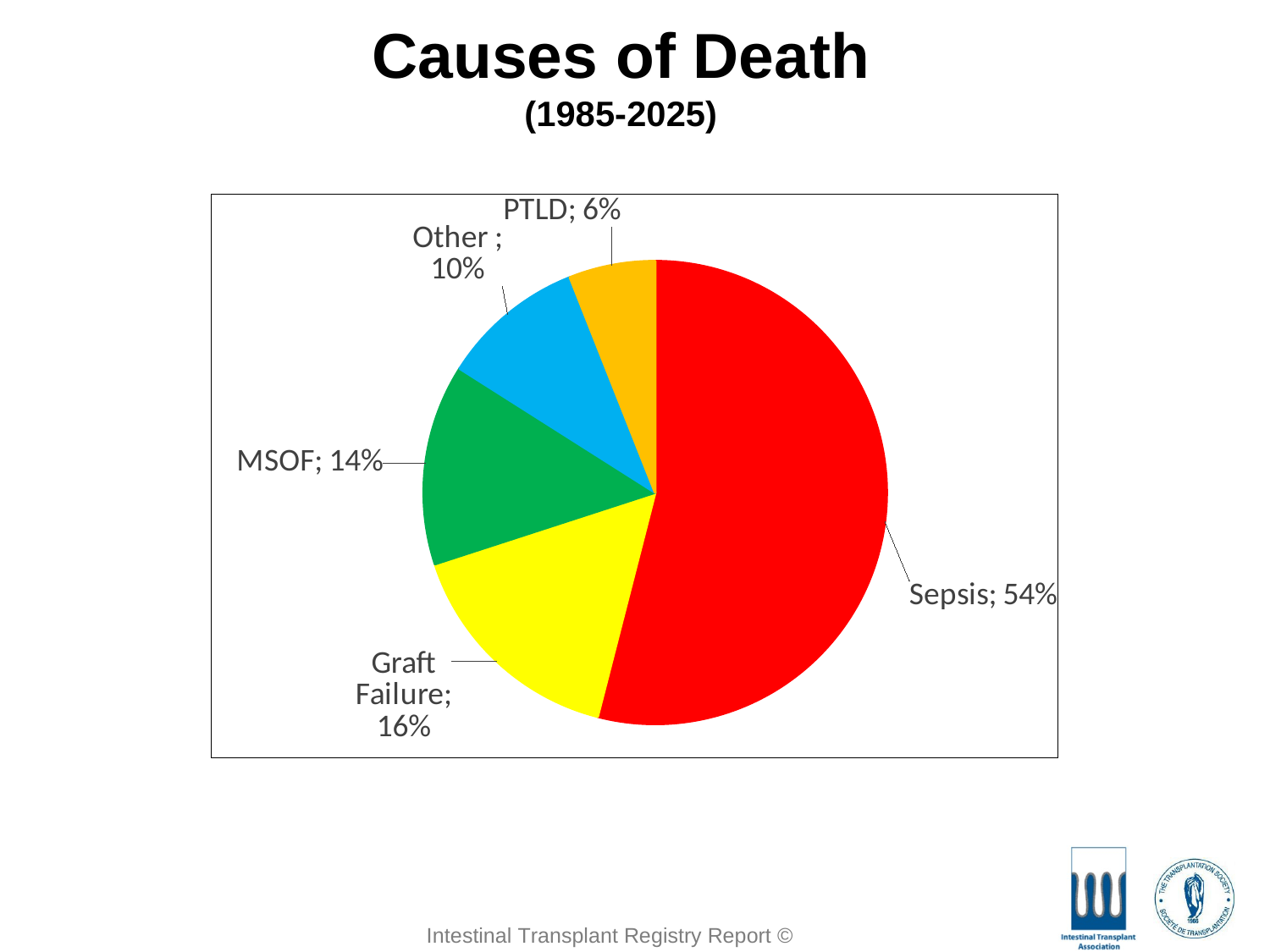
Which is larger, the share for MSOF or the share for Other? MSOF What share of deaths is attributed to Sepsis? 54% What type of chart is shown on the slide? Pie chart What percentage is shown for PTLD? 6% What percentage of deaths is due to Graft Failure? 16% How many categories are shown in the pie chart? 5 What is the difference in percentage points between Sepsis and Graft Failure? 38 What is the title of the chart on the slide? Causes of Death (1985-2025) Which cause of death has the smallest slice of the pie? PTLD What colour is the slice for Graft Failure? Yellow Which cause of death has the largest slice of the pie? Sepsis What is the value shown for MSOF? 14%